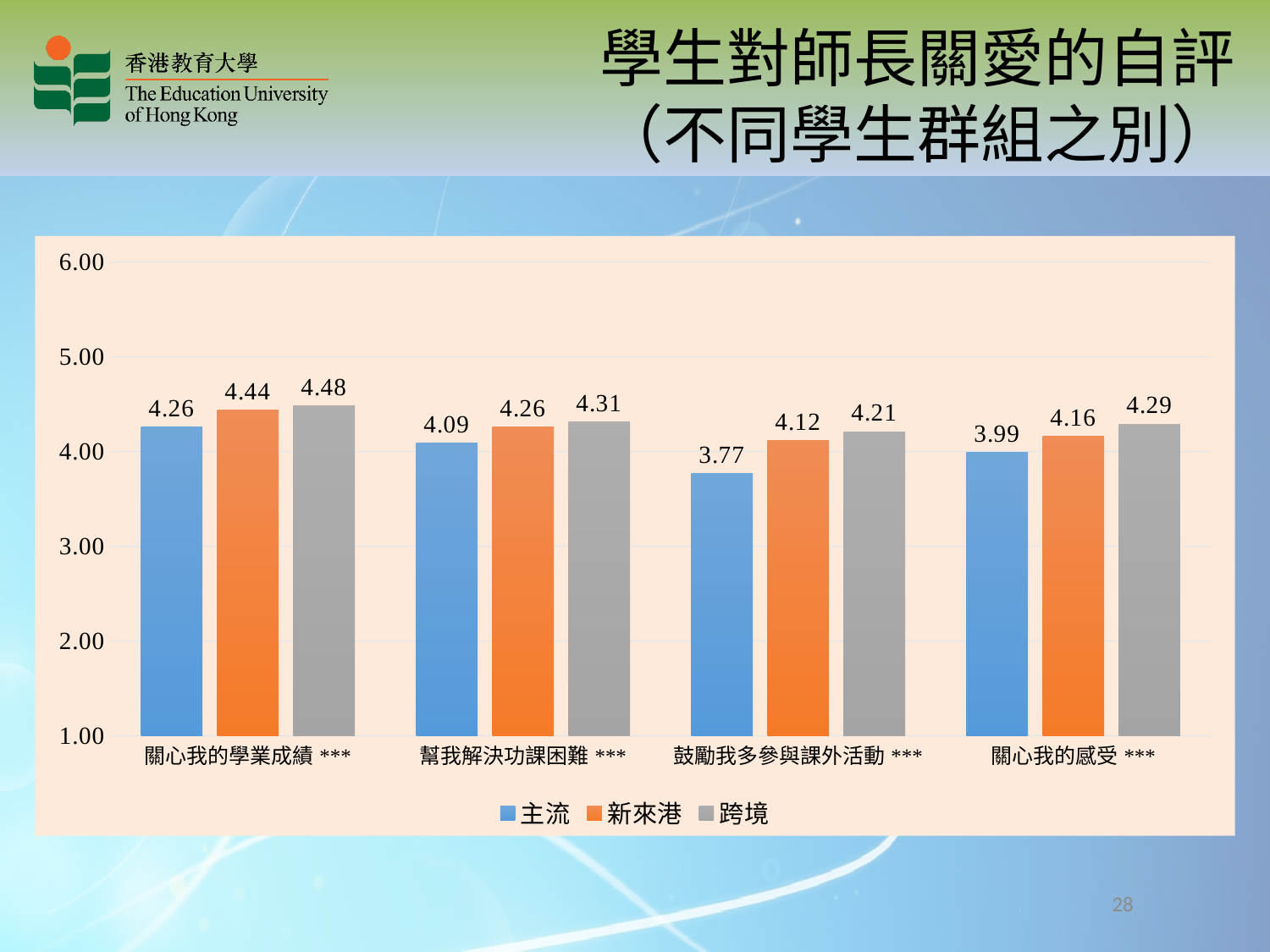
Is the value for 主流 in the category 關心我的感受 *** greater or less than 3.00? greater What is the value for 跨境 in the category 鼓勵我多參與課外活動 ***? 4.21 What is the value for 主流 in the category 關心我的學業成績 ***? 4.26 Which series is shown in orange in the legend? 新來港 What kind of chart is shown on the slide? bar chart Which category has the lowest value for 主流? 鼓勵我多參與課外活動 *** What is the difference between the 跨境 and 主流 values in the category 鼓勵我多參與課外活動 ***? 0.44 Which category has the highest value for 跨境? 關心我的學業成績 *** How many series does the legend list? 3 How many categories are shown on the x axis? 4 In the category 幫我解決功課困難 ***, which is larger: the value for 主流 or the value for 跨境? 跨境 What is the value for 新來港 in the category 關心我的感受 ***? 4.16